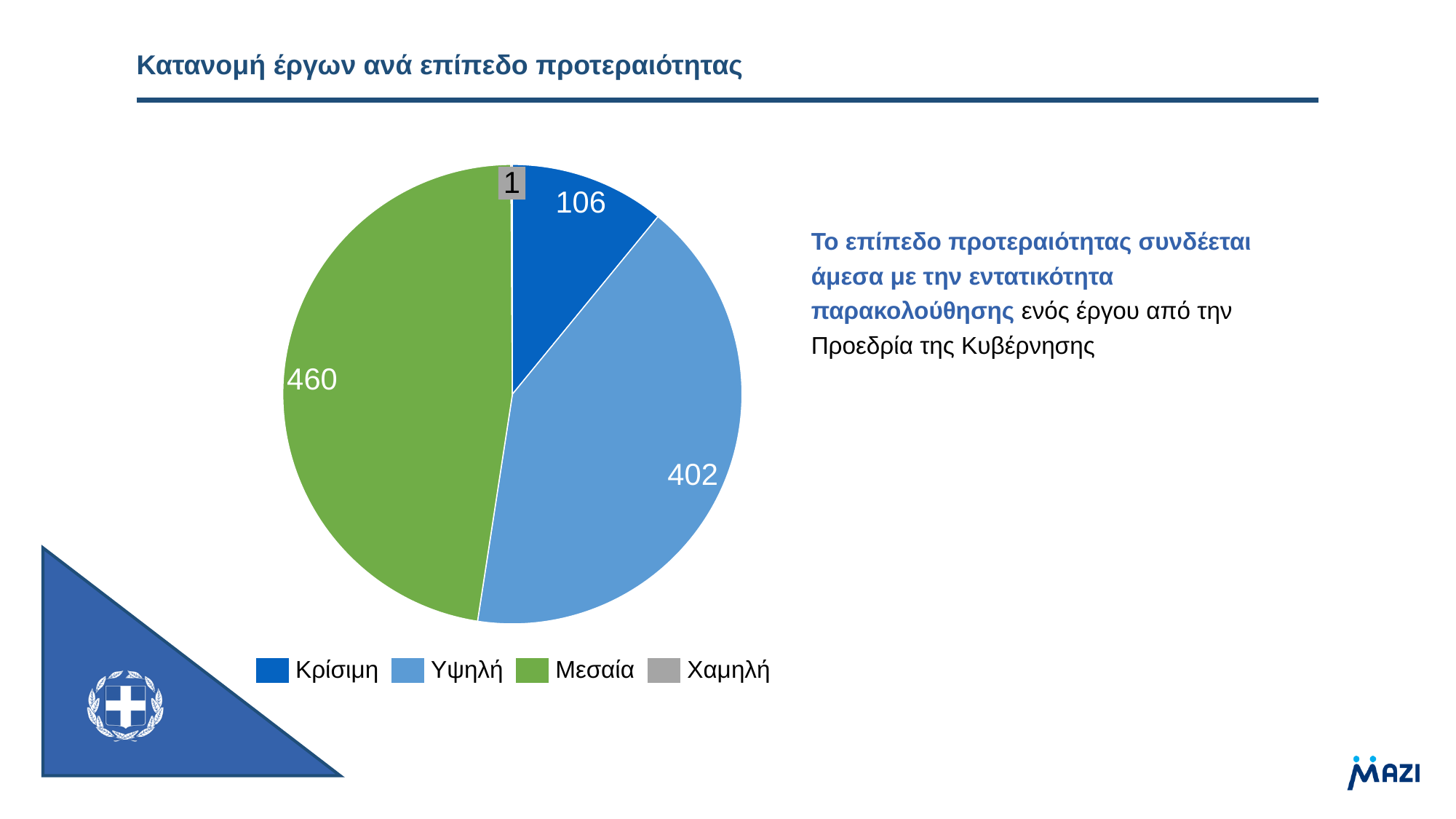
What is the difference between the values for Μεσαία and Υψηλή? 58 Which priority level has the smallest slice in the pie chart? Χαμηλή What is the difference between the values for Υψηλή and Κρίσιμη? 296 What is the value for Μεσαία in the pie chart? 460 What is the value for Χαμηλή in the pie chart? 1 What is the title of the chart on the slide? Κατανομή έργων ανά επίπεδο προτεραιότητας What kind of chart is shown on the slide? Pie chart What is the value for Υψηλή in the pie chart? 402 Which priority level has the largest slice in the pie chart? Μεσαία How many slices does the pie chart have? 4 What is the value for Κρίσιμη in the pie chart? 106 Which is larger, the value for Κρίσιμη or the value for Υψηλή? Υψηλή